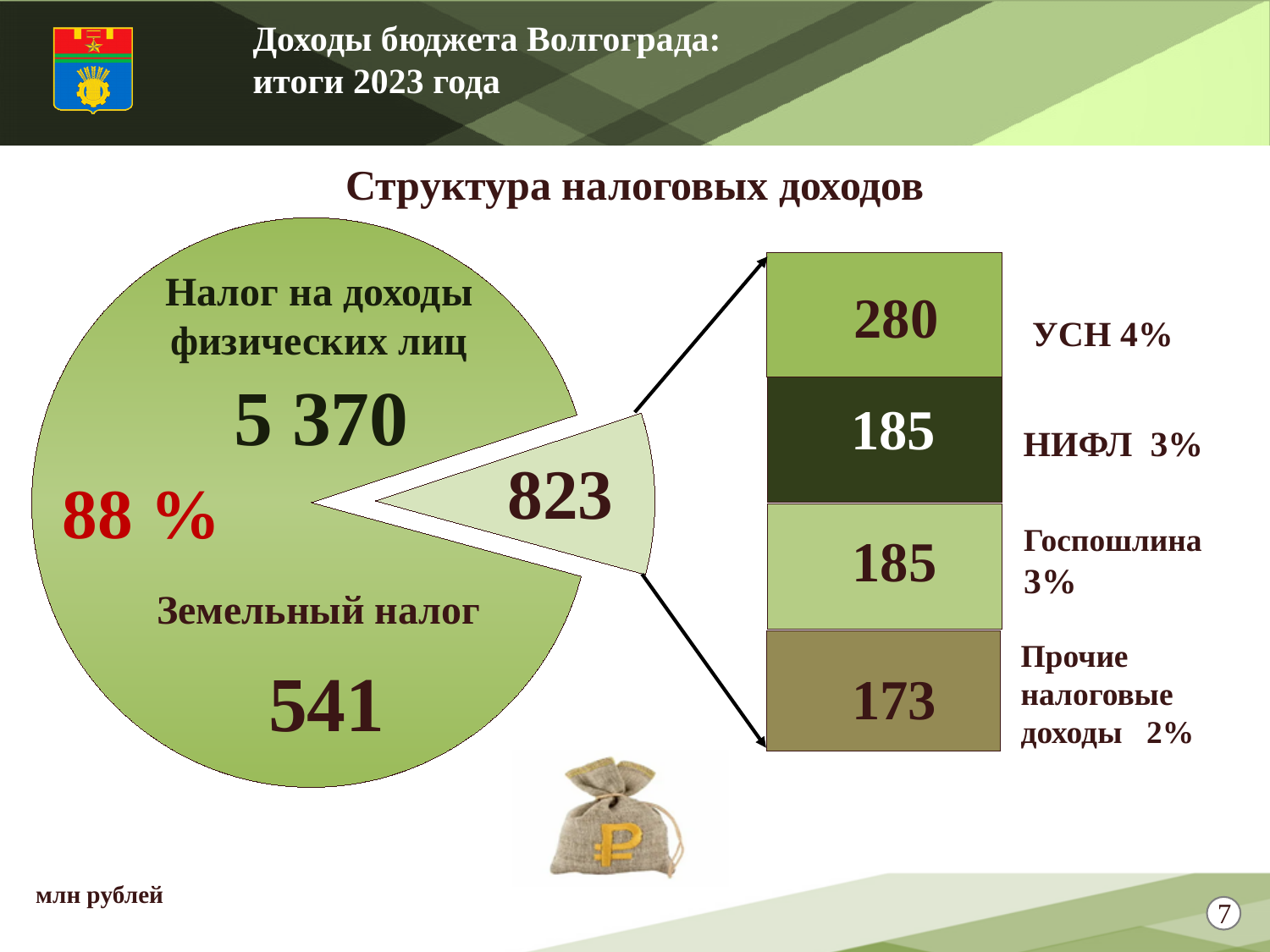
What is the difference between the values for УСН and НИФЛ in the stacked bar? 95 What type of chart is the main chart on the left of the slide? pie chart In the stacked bar on the right, what is the value for Прочие налоговые доходы? 173 What percentage share is shown for the large pie slice? 88 % In the stacked bar on the right, which segment has the highest value? УСН What is the title of the chart on the slide? Структура налоговых доходов In the stacked bar on the right, which segment has the lowest value? Прочие налоговые доходы What is the value for Земельный налог? 541 In the stacked bar on the right, what is the value for УСН? 280 What is the total of the four segments in the stacked bar on the right? 823 What is the value for Налог на доходы физических лиц? 5 370 What is the value of the small pie slice that is broken down in the stacked bar on the right? 823